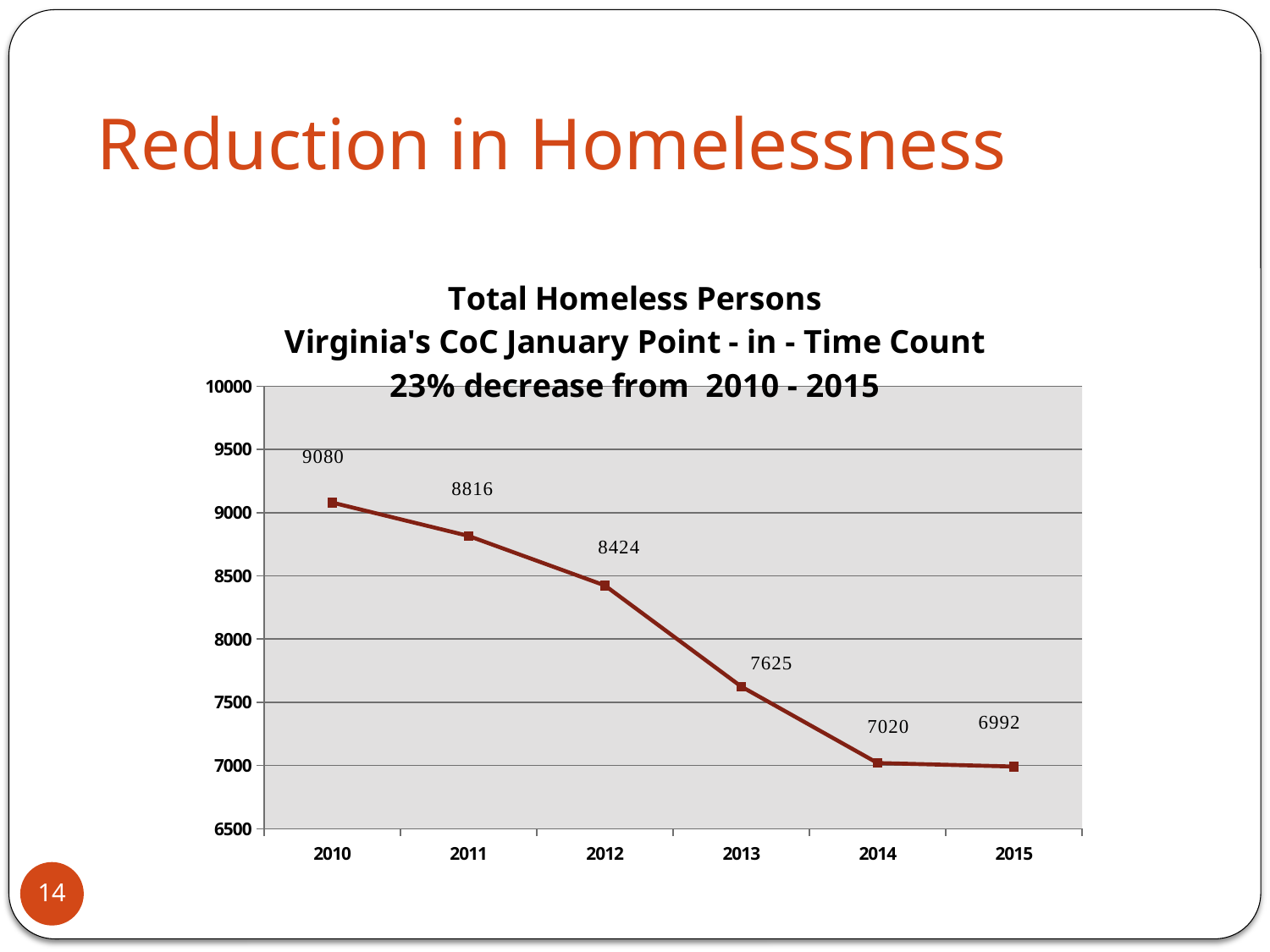
What is the difference between the 2010 value and the 2015 value? 2088 What is the value plotted for 2015? 6992 Which year has the lowest value? 2015 How many years are plotted on the chart? 6 Which year has the highest value? 2010 Which is larger, the value for 2011 or the value for 2012? 2011 What kind of chart is shown? line chart Is the value for 2013 greater or less than 8000? less What is the total homeless persons value for 2010? 9080 What is the difference between the 2012 value and the 2013 value? 799 Do the values rise or fall from 2010 to 2015? fall What is the value plotted for 2013? 7625